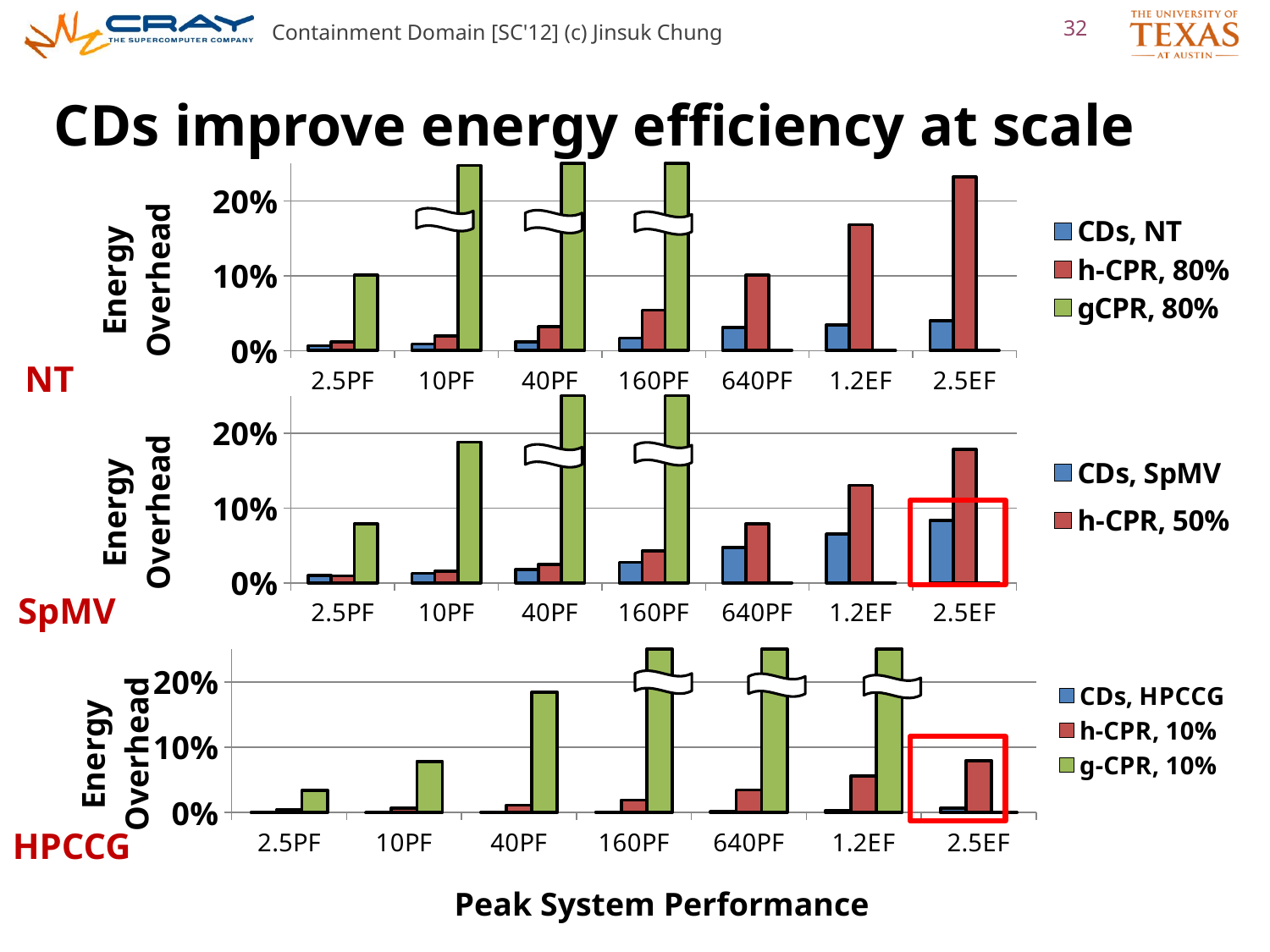
What is the x-axis title shared by the charts? Peak System Performance In the HPCCG chart, is the value for g-CPR, 10% at 40PF greater or less than 10%? greater In the NT chart, which category has the highest value for CDs, NT? 2.5EF In the NT chart, do the values for CDs, NT rise or fall from 2.5PF to 2.5EF? rise How many series does the legend of the SpMV chart list? 2 In the SpMV chart, is the value for h-CPR, 50% at 2.5EF greater or less than 10%? greater How many series does the legend of the NT chart list? 3 In the NT chart, is the value for h-CPR, 80% at 2.5EF greater or less than 20%? greater What kind of chart is the top (NT) chart? bar chart How many categories are shown on the x axis of the SpMV chart? 7 In the SpMV chart, which is larger at 2.5EF: CDs, SpMV or h-CPR, 50%? h-CPR, 50%